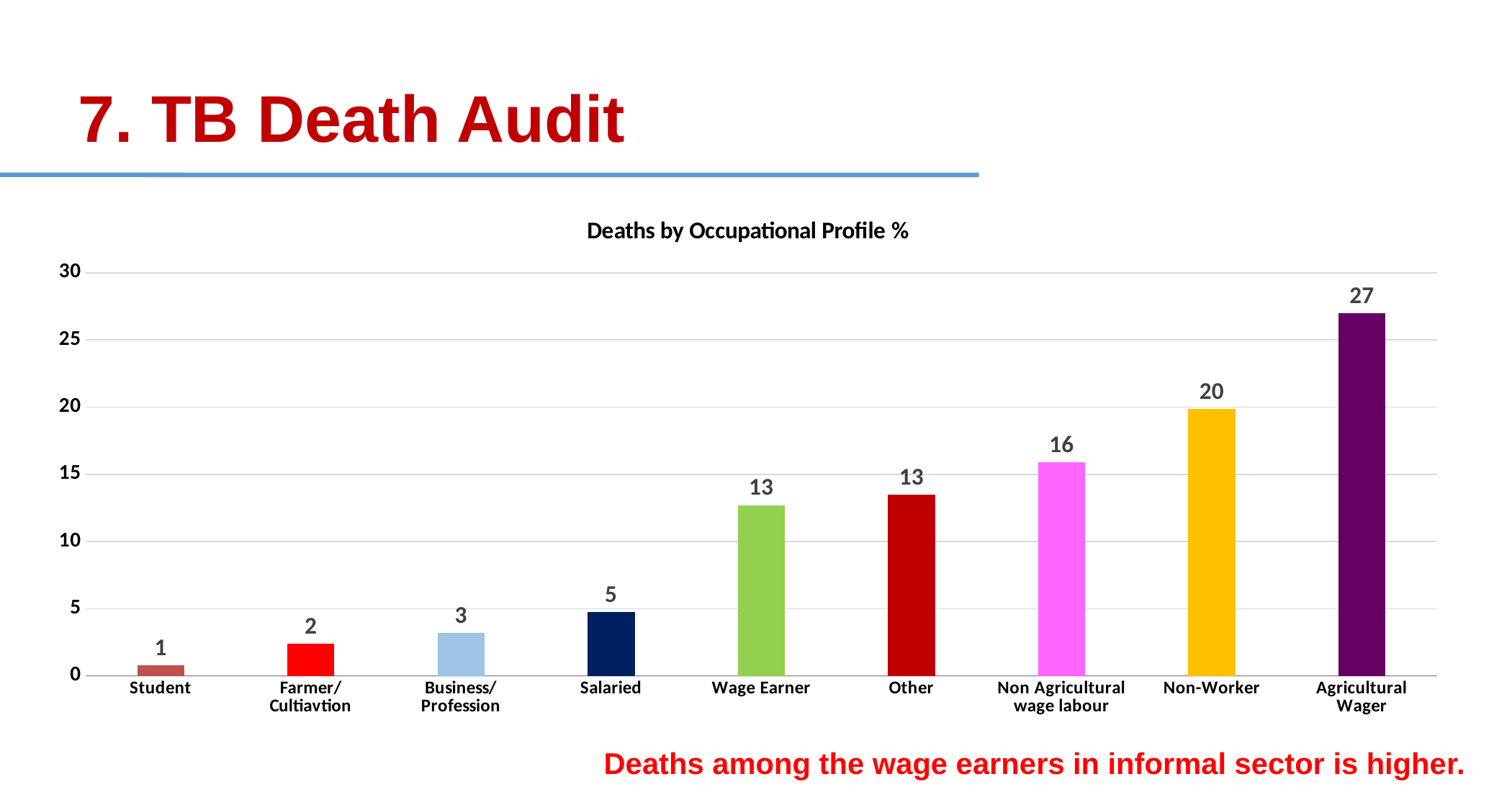
Which is larger, the value for Non Agricultural wage labour or the value for Wage Earner? Non Agricultural wage labour What kind of chart is shown on the slide? Bar chart What is the value for Agricultural Wager in the Deaths by Occupational Profile % chart? 27 What is the value for Salaried? 5 What is the title of the chart? Deaths by Occupational Profile % What is the value for Non Agricultural wage labour? 16 What is the difference between the values for Agricultural Wager and Non-Worker? 7 What is the value for Non-Worker? 20 Do the values generally rise or fall from left to right across the categories? Rise Which occupational category has the highest value? Agricultural Wager How many occupational categories are shown in the chart? 9 Which occupational category has the lowest value? Student